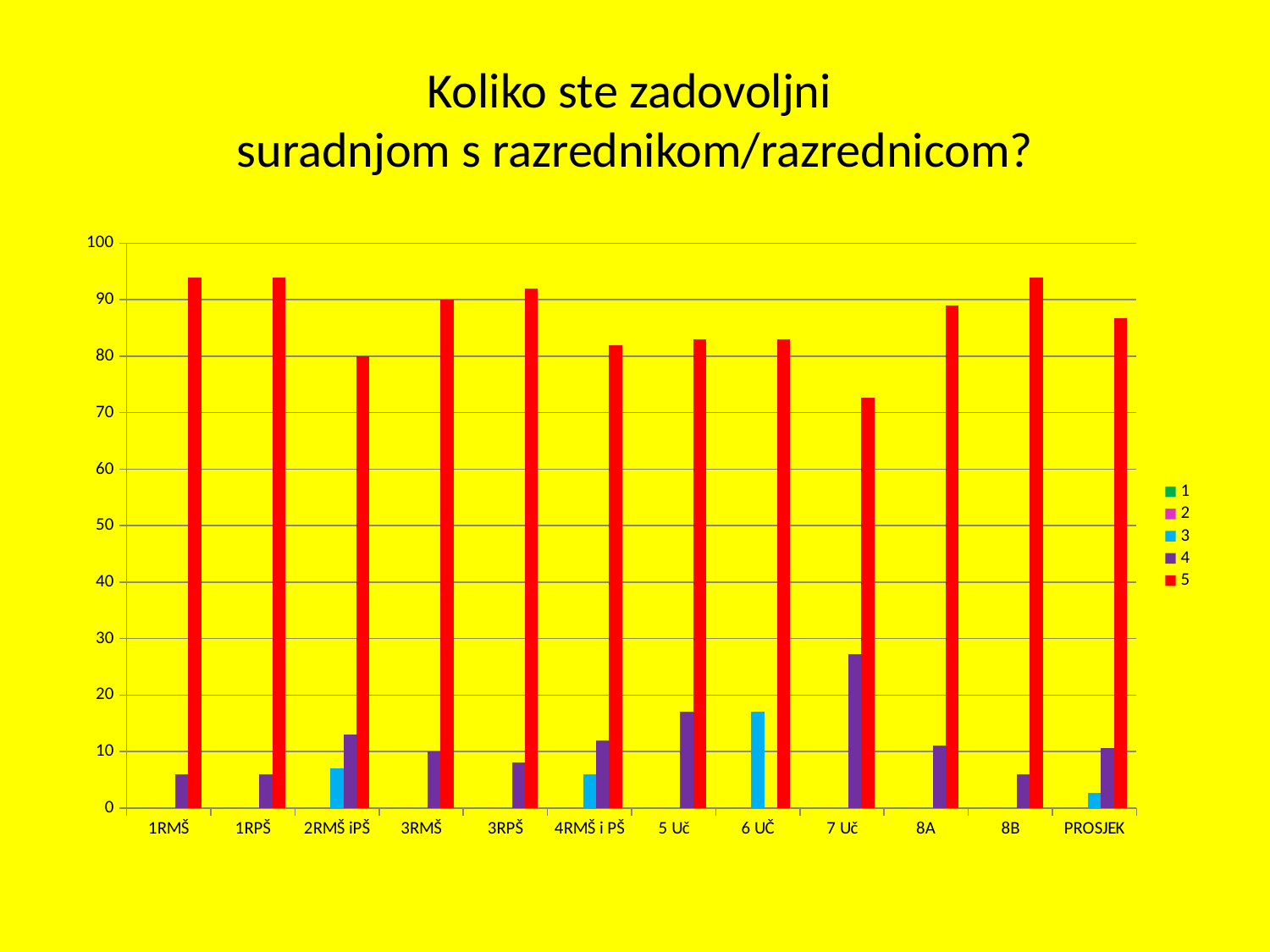
What is the title of the chart? Koliko ste zadovoljni suradnjom s razrednikom/razrednicom? Is the value of series 5 for 1RMŠ greater or less than 90? greater Which category has the larger value for series 3: 6 UČ or 2RMŠ iPŠ? 6 UČ How many categories are shown along the x axis? 12 What kind of chart is shown on the slide? bar chart What colour represents series 5 in the chart? red Is the value of series 4 for 7 Uč greater or less than 20? greater Which is larger for series 5: 8A or 7 Uč? 8A Which category has the lowest value for series 5? 7 Uč Is the value of series 5 for 7 Uč greater or less than 80? less Which category has the highest value for series 4? 7 Uč How many series does the legend list? 5